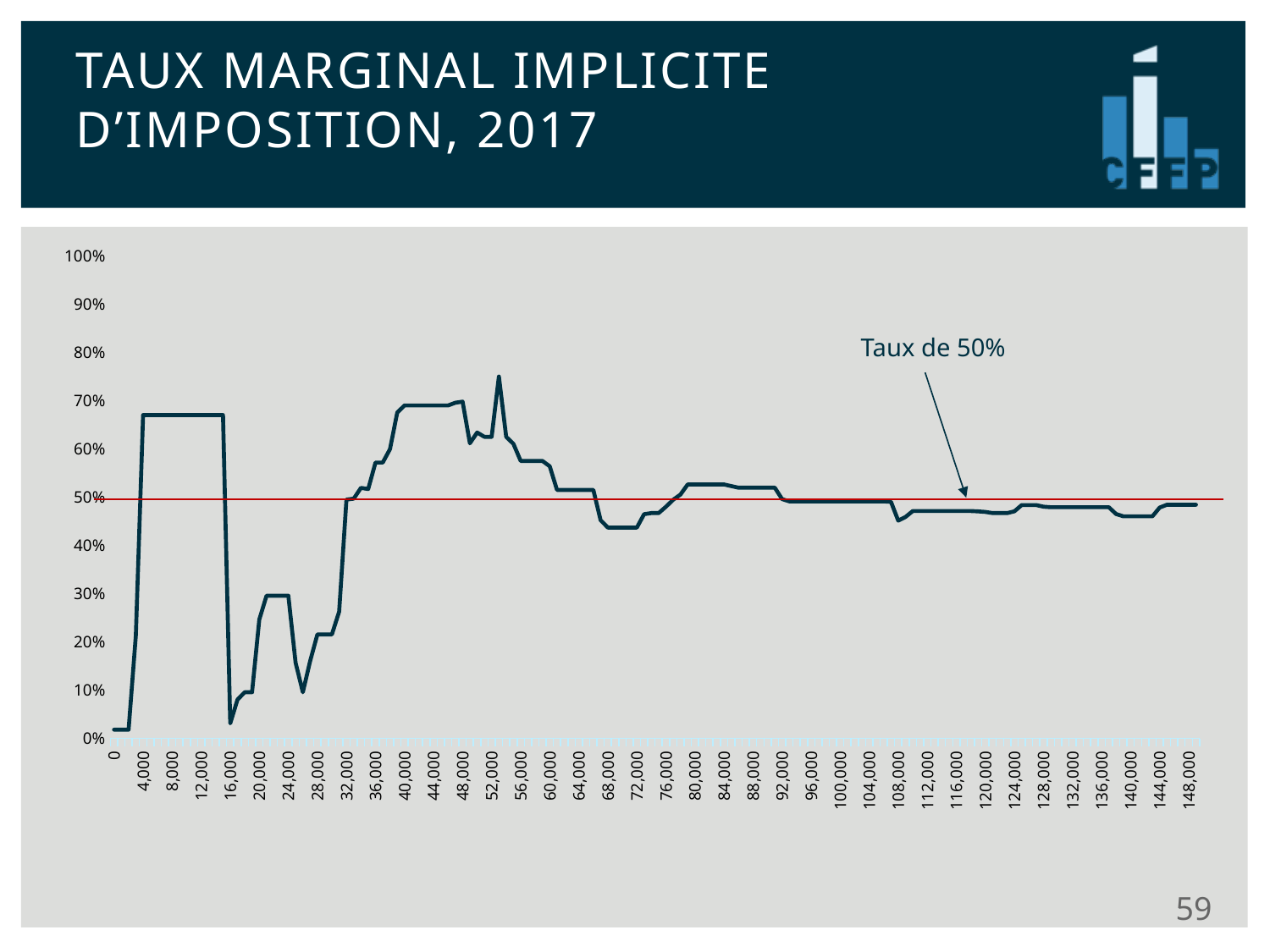
Is the value of the line at 40,000 greater or less than 60%? greater What is the title of the slide's chart? TAUX MARGINAL IMPLICITE D'IMPOSITION, 2017 Does the line rise or fall between 56,000 and 64,000? fall Does the line rise or fall between 32,000 and 40,000? rise Is the value of the line at 108,000 greater or less than 50%? less Is the value of the line at 8,000 greater or less than 60%? greater What kind of chart is shown on the slide? line chart What rate does the red horizontal line on the chart mark, according to the annotation? Taux de 50%